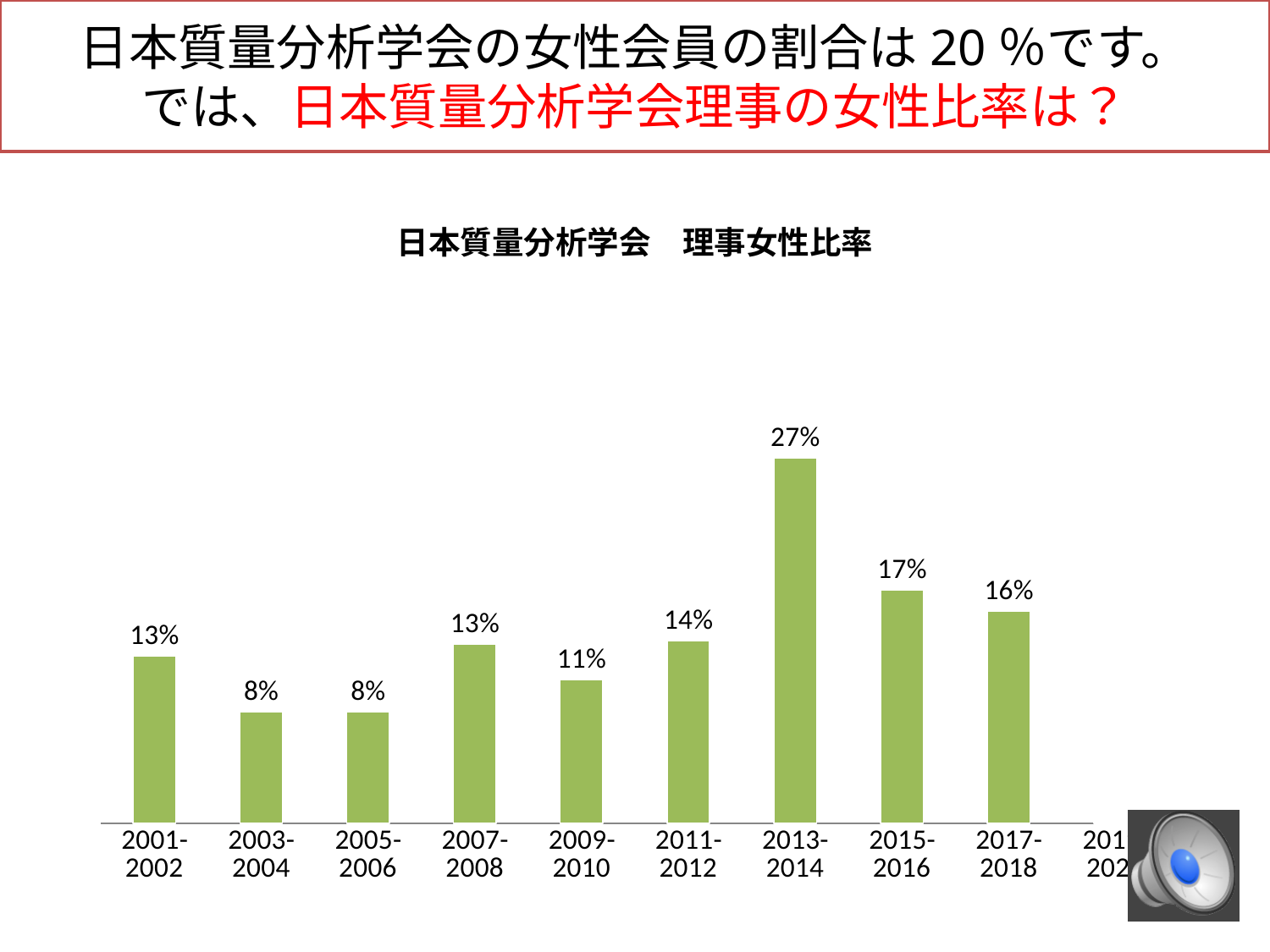
What is the value for 2001-2002? 13% Do the values rise or fall from 2013-2014 to 2017-2018? fall What is the value for 2013-2014? 27% What is the difference between the values for 2013-2014 and 2015-2016? 10% What is the value for 2015-2016? 17% What kind of chart is shown on the slide? bar chart Which is larger, the value for 2007-2008 or the value for 2009-2010? 2007-2008 What is the value for 2017-2018? 16% What is the title of the chart? 日本質量分析学会 理事女性比率 What is the value for 2009-2010? 11% What is the difference between the values for 2011-2012 and 2003-2004? 6%